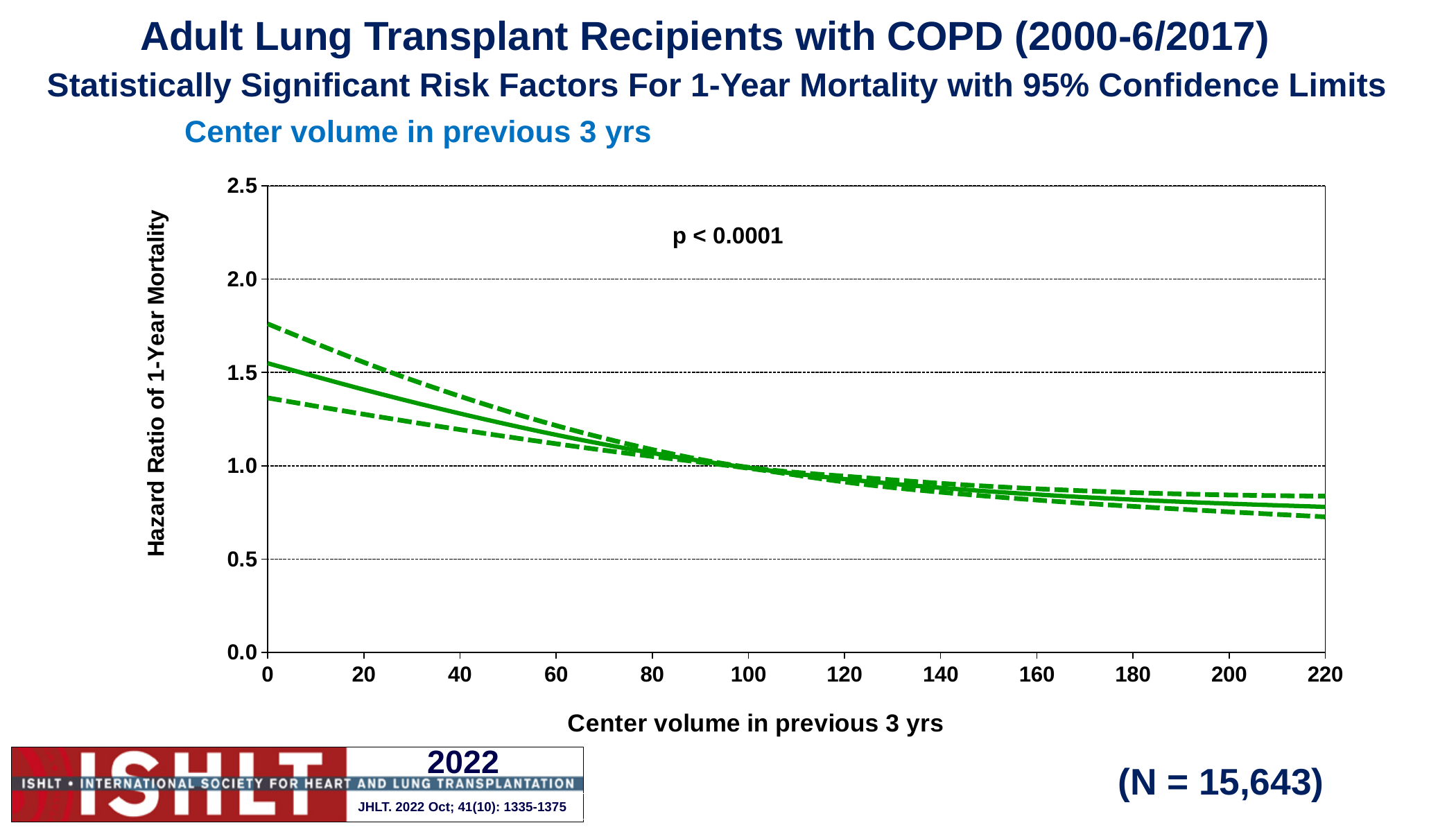
What is the highest value shown on the x axis? 220 Does the hazard ratio rise or fall as center volume in previous 3 yrs increases? fall Is the upper dashed confidence limit at a center volume of 0 greater or less than 1.5? greater Is the hazard ratio on the solid line at a center volume of 220 greater or less than 1.0? less Is the hazard ratio on the solid line at a center volume of 40 greater or less than 1.0? greater What p-value is printed on the chart? p < 0.0001 What is the label of the y axis? Hazard Ratio of 1-Year Mortality What kind of chart is shown on the slide? line chart What is the highest value shown on the y axis? 2.5 How many lines are plotted on the chart? 3